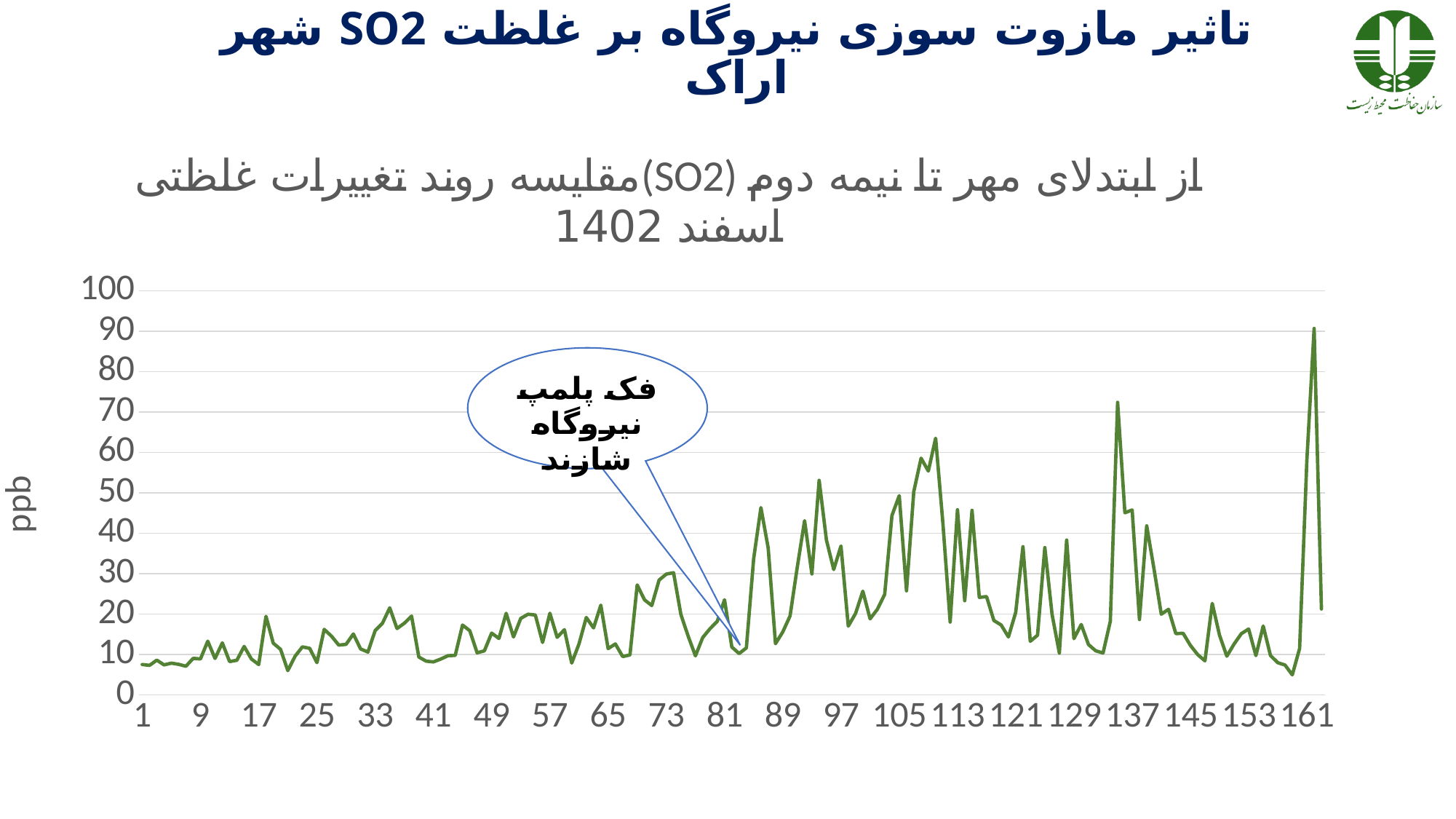
Is the value at the first point (x = 1) greater or less than 10? less Which is larger: the peak near x = 161 or the peak near x = 137? the peak near x = 161 What text is written in the callout bubble pointing at the line? فک پلمپ نیروگاه شازند How many lines (series) are plotted on the chart? 1 Is the peak near x = 137 greater or less than 60? greater Is the peak near x = 109 greater or less than 50? greater What kind of chart is shown on the slide? line chart What unit is shown on the vertical axis label of the chart? ppb Near which x-axis tick label does the line reach its highest value? 161 What is the highest tick value shown on the vertical axis? 100